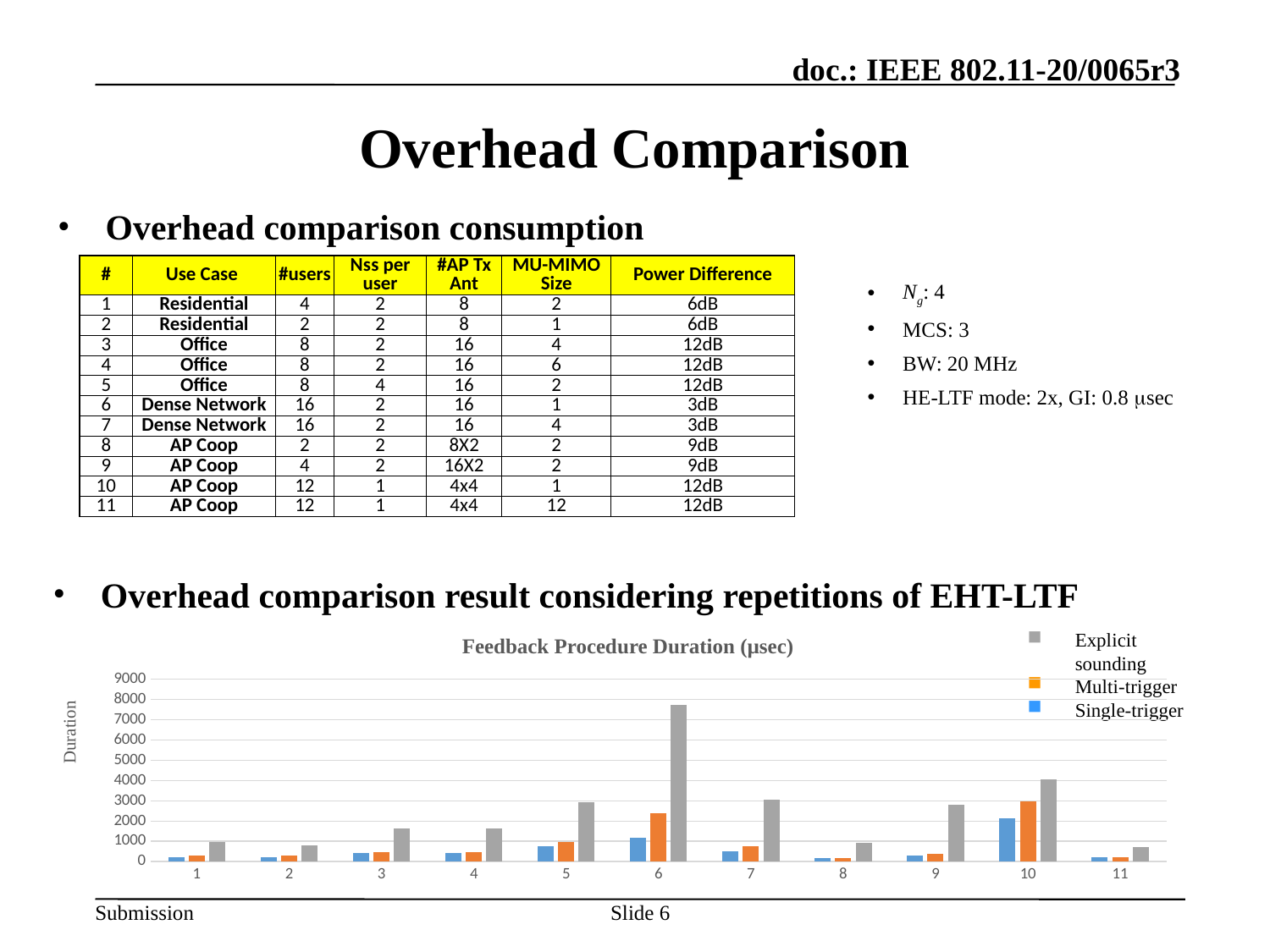
What is the title of the chart on the slide? Feedback Procedure Duration (μsec) What kind of chart is shown at the bottom of the slide? bar chart In the Feedback Procedure Duration chart, which category has the highest Explicit sounding value? 6 In the Feedback Procedure Duration chart, which series has the highest value for category 6? Explicit sounding In the Feedback Procedure Duration chart, which is larger: the Single-trigger value for category 10 or for category 6? category 10 In the Feedback Procedure Duration chart, is the Single-trigger value for category 1 greater or less than 1000? less In the Feedback Procedure Duration chart, is the Explicit sounding value for category 3 greater or less than 1000? greater How many series does the legend of the Feedback Procedure Duration chart list? 3 How many categories are shown along the x axis of the Feedback Procedure Duration chart? 11 In the Feedback Procedure Duration chart, is the Multi-trigger value for category 6 greater or less than 2000? greater In the Feedback Procedure Duration chart, which is larger: the Explicit sounding value for category 6 or for category 10? category 6